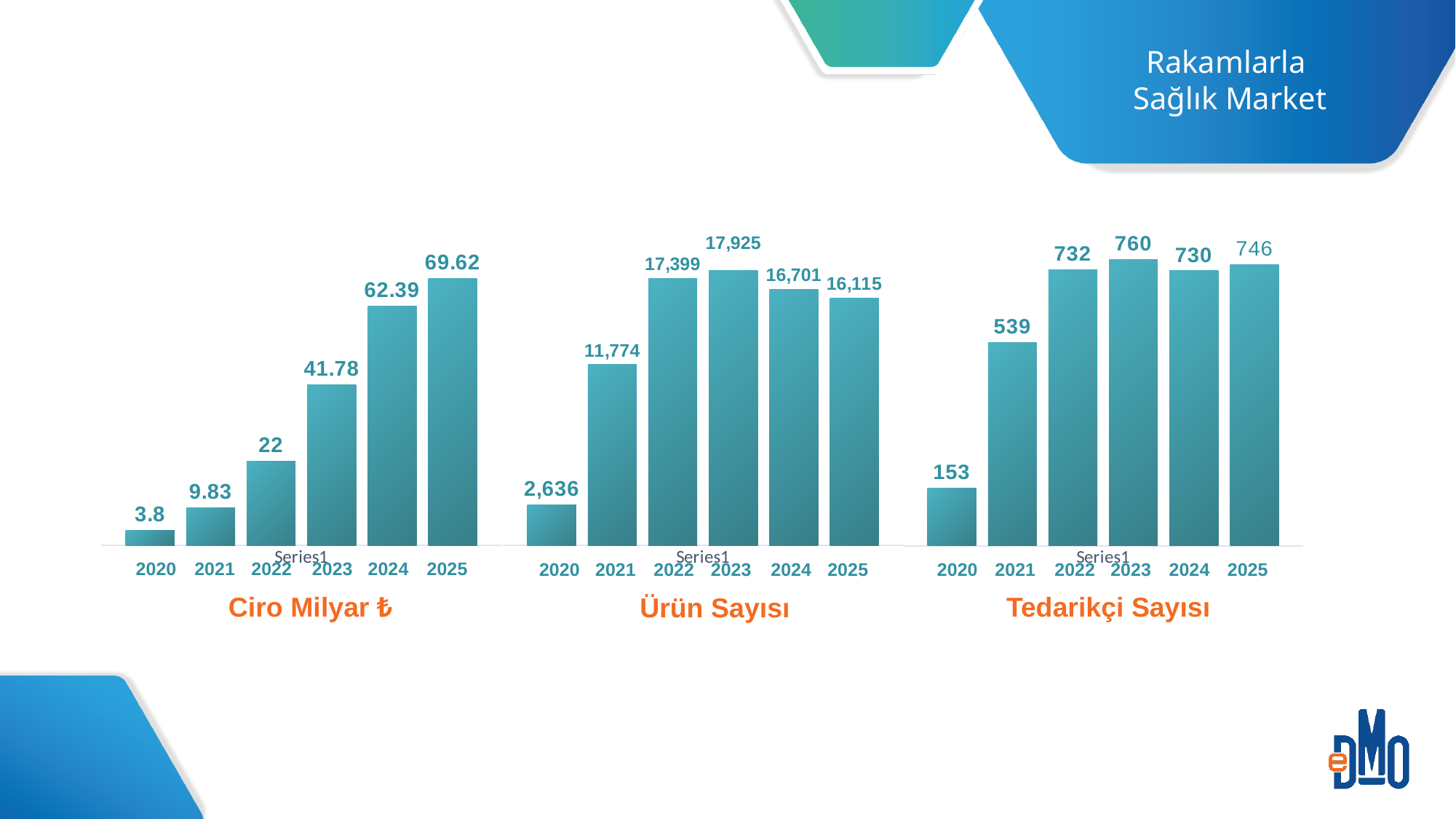
In the 'Ciro Milyar ₺' chart, do the values rise or fall from 2020 to 2025? rise In the 'Ürün Sayısı' chart, which year has the lowest value? 2020 In the 'Tedarikçi Sayısı' chart, what is the difference between the 2021 and 2020 values? 386 How many years are shown in the 'Tedarikçi Sayısı' chart? 6 In the 'Ciro Milyar ₺' chart, what is the difference between the 2025 and 2024 values? 7.23 What kind of chart is the 'Ürün Sayısı' chart? bar chart In the 'Ürün Sayısı' chart, what is the value for 2021? 11,774 In the 'Ürün Sayısı' chart, which is larger, the value for 2022 or the value for 2024? 2022 In the 'Ciro Milyar ₺' chart, what is the value for 2023? 41.78 In the 'Ciro Milyar ₺' chart, which year has the highest value? 2025 In the 'Ürün Sayısı' chart, which year has the highest value? 2023 In the 'Tedarikçi Sayısı' chart, what is the value for 2025? 746